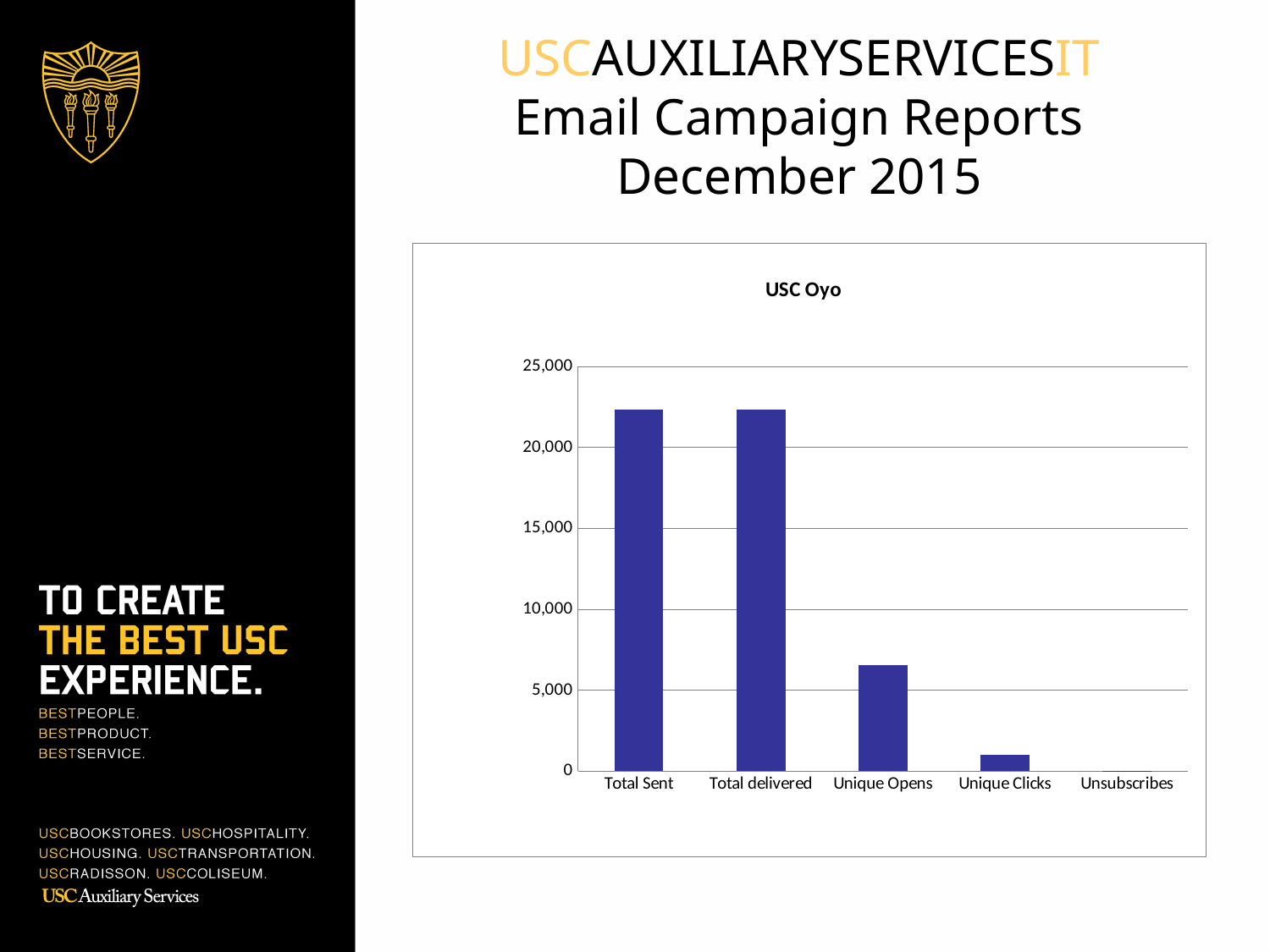
What type of chart is shown on the slide? bar chart Is the value for Total delivered greater or less than 25,000? less Which category has the lowest value in the chart? Unsubscribes Which is larger, Total Sent or Unique Opens? Total Sent Is the value for Total Sent greater or less than 20,000? greater How many categories are shown on the x axis of the chart? 5 Is the value for Unique Opens greater or less than 5,000? greater Which is larger, Unique Opens or Unique Clicks? Unique Opens Do the values generally rise or fall moving from left to right along the x axis? fall What is the title of the chart? USC Oyo